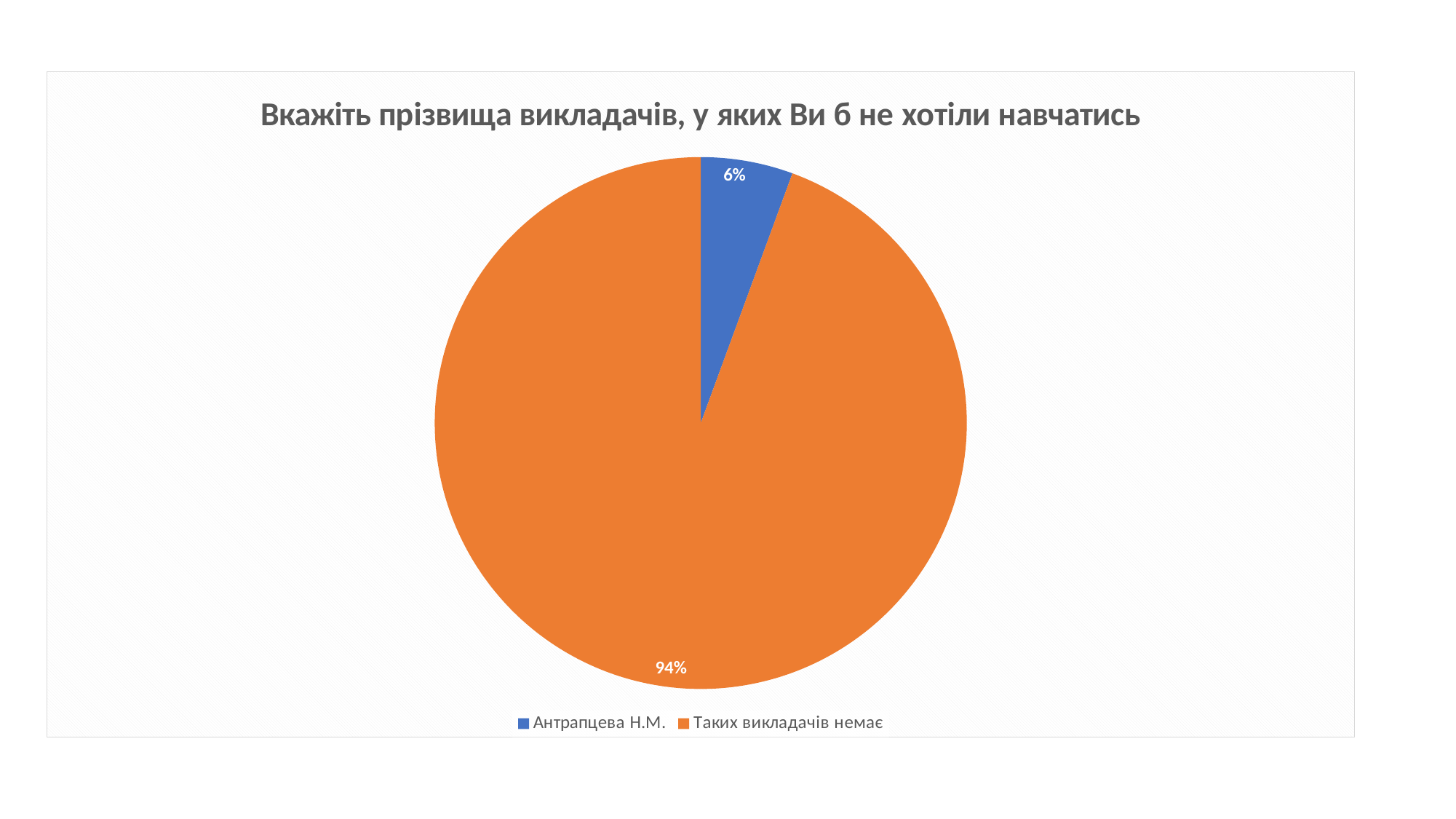
Which slice of the pie is the smallest? Антрапцева Н.М. Which is larger: the slice for "Антрапцева Н.М." or the slice for "Таких викладачів немає"? Таких викладачів немає What kind of chart is shown on the slide? pie chart How many entries does the legend list? 2 How many slices does the pie chart have? 2 Which slice of the pie is the largest? Таких викладачів немає What share of the pie does "Таких викладачів немає" take? 94% What is the title of the chart? Вкажіть прізвища викладачів, у яких Ви б не хотіли навчатись What share of the pie does "Антрапцева Н.М." take? 6% What is the difference in percentage points between "Таких викладачів немає" and "Антрапцева Н.М."? 88 What colour is the slice for "Антрапцева Н.М."? blue